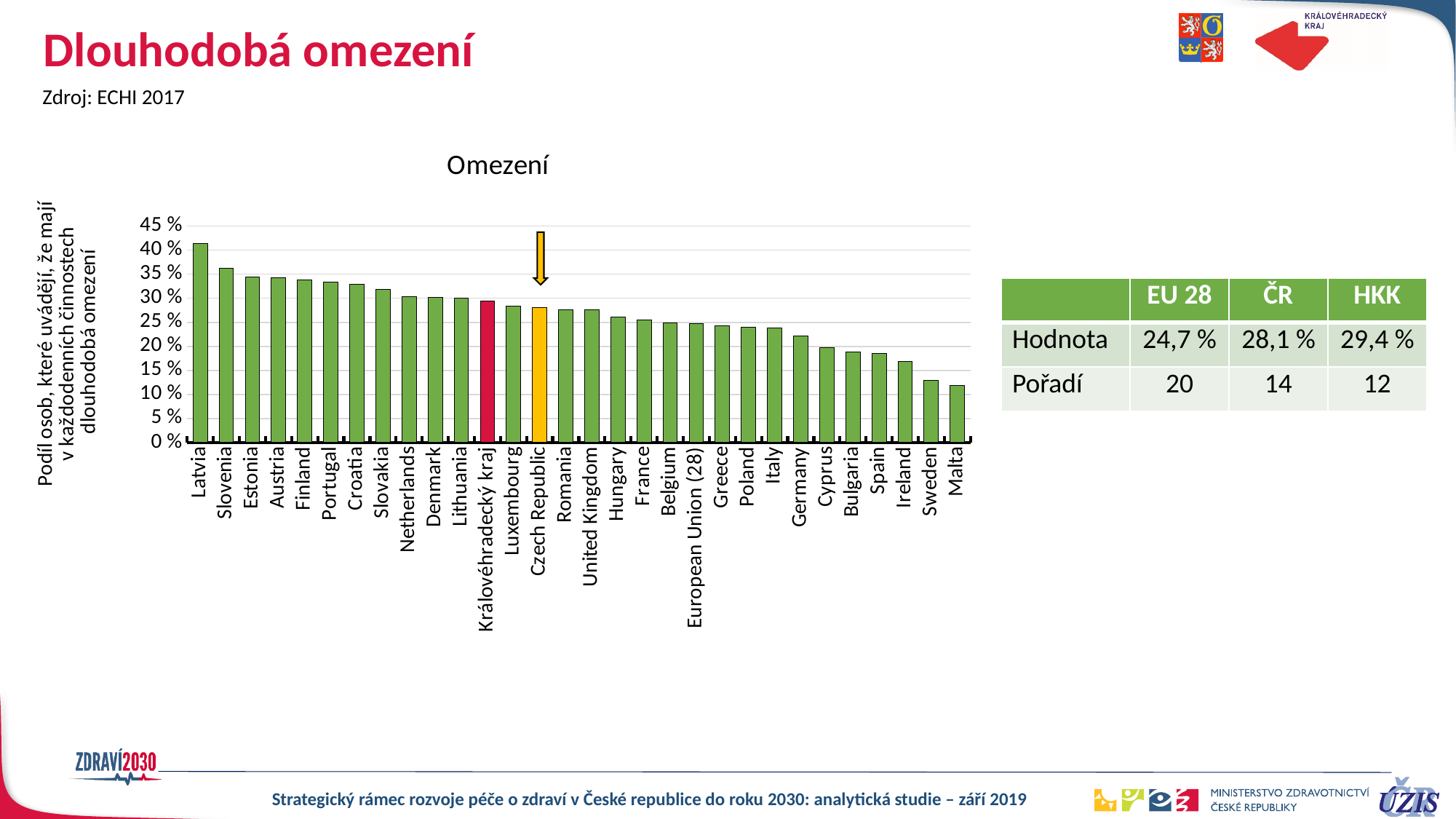
Do the values rise or fall from left to right along the x axis? fall How many bars (categories) are plotted in the chart? 30 Is the value for Latvia greater or less than 35 %? greater What is the value for Královéhradecký kraj (HKK) according to the table? 29,4 % Which country has the highest value in the chart? Latvia What is the value for the Czech Republic (ČR) according to the table? 28,1 % What is the title of the chart? Omezení Which is larger, the value for the Czech Republic or the value for European Union (28)? Czech Republic What type of chart is shown on the slide? bar chart What is the value for European Union (28) according to the table? 24,7 % Which country has the lowest value in the chart? Malta What is the difference between the values for ČR and EU 28 in the table? 3,4 percentage points